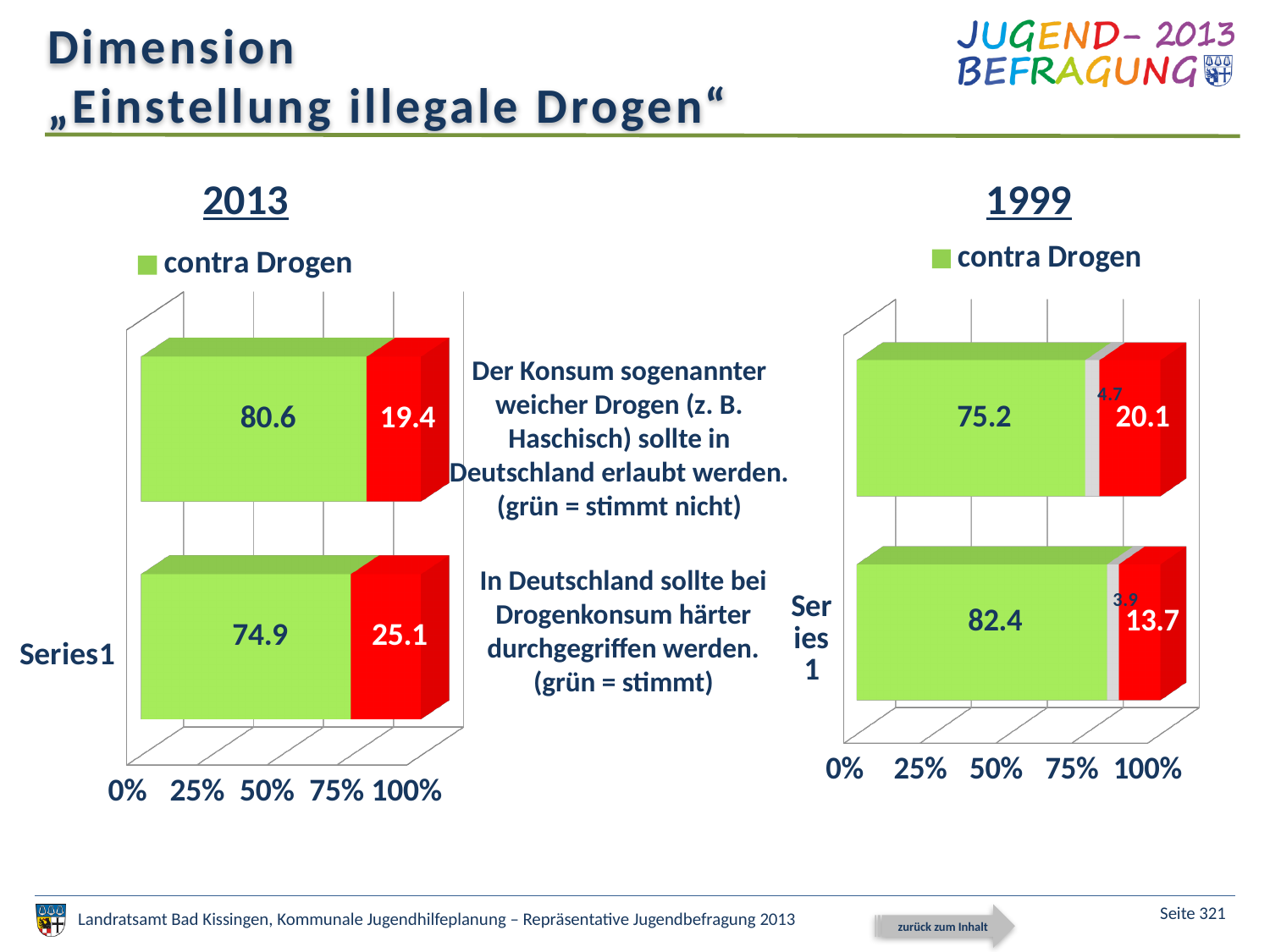
How many bars does the 2013 chart on the left show? 2 In the 2013 chart on the left, what is the value of the green segment in the top bar? 80.6 In the 2013 chart on the left, what is the total of the top stacked bar? 100 In the 1999 chart on the right, what is the value of the green segment in the top bar? 75.2 In the 2013 chart on the left, what is the value of the red segment in the bottom bar? 25.1 In the 1999 chart on the right, what is the value of the small grey segment in the top bar? 4.7 In the 1999 chart on the right, what is the difference between the red values of the top bar and the bottom bar? 6.4 How many entries does the legend of the 1999 chart on the right list? 1 What kind of chart is the 2013 chart on the left? bar chart In the 1999 chart on the right, which bar has the larger green value, the top bar or the bottom bar? bottom bar In the 1999 chart on the right, what is the value of the red segment in the bottom bar? 13.7 In the 2013 chart on the left, what is the difference between the green values of the top bar and the bottom bar? 5.7